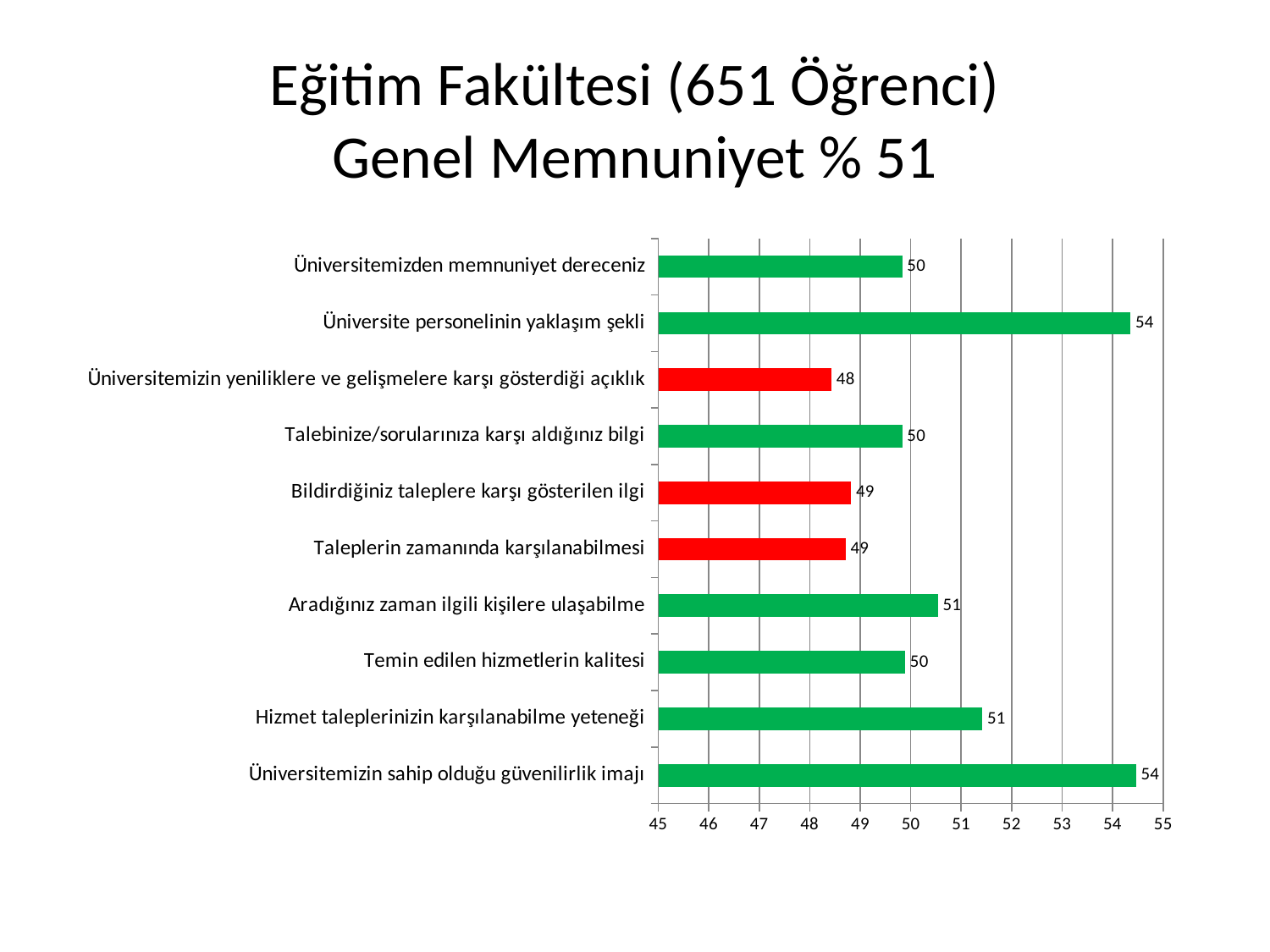
Which category has the lowest value? Üniversitemizin yeniliklere ve gelişmelere karşı gösterdiği açıklık What is the difference between the value for "Üniversitemizin sahip olduğu güvenilirlik imajı" and the value for "Üniversitemizin yeniliklere ve gelişmelere karşı gösterdiği açıklık"? 6 What overall satisfaction percentage is stated in the slide title? % 51 How many bars in the chart are coloured red? 3 Is the value for "Üniversitemizin sahip olduğu güvenilirlik imajı" greater or less than 52? greater What value is shown for "Taleplerin zamanında karşılanabilmesi"? 49 What value is shown for "Aradığınız zaman ilgili kişilere ulaşabilme"? 51 How many categories are plotted in the chart? 10 Which is larger: the value for "Üniversite personelinin yaklaşım şekli" or the value for "Temin edilen hizmetlerin kalitesi"? Üniversite personelinin yaklaşım şekli What kind of chart is shown on the slide? bar chart What value is shown for "Üniversitemizden memnuniyet dereceniz"? 50 What value is shown for "Üniversite personelinin yaklaşım şekli"? 54